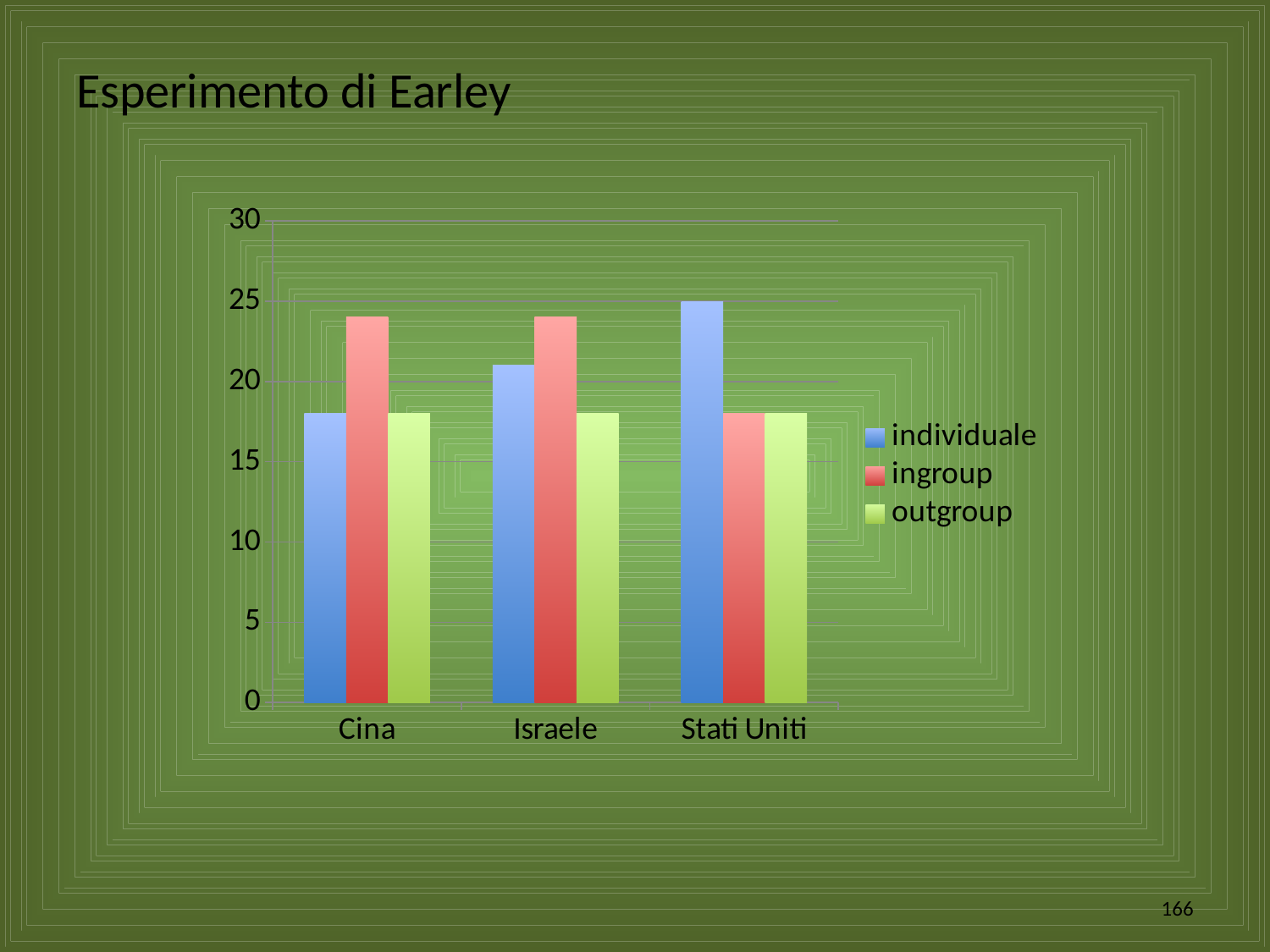
Which is larger for Stati Uniti, individuale or ingroup? individuale What kind of chart is shown on the slide? bar chart What is the title of the slide? Esperimento di Earley Is the value for individuale in Israele greater or less than 20? greater Is the value for individuale in Cina greater or less than 20? less How many categories are shown on the x axis? 3 Is the value for ingroup in Stati Uniti greater or less than 20? less Which is larger for Cina, individuale or ingroup? ingroup What is the value for individuale in Stati Uniti? 25 Which category has the highest value for individuale? Stati Uniti How many series does the legend list? 3